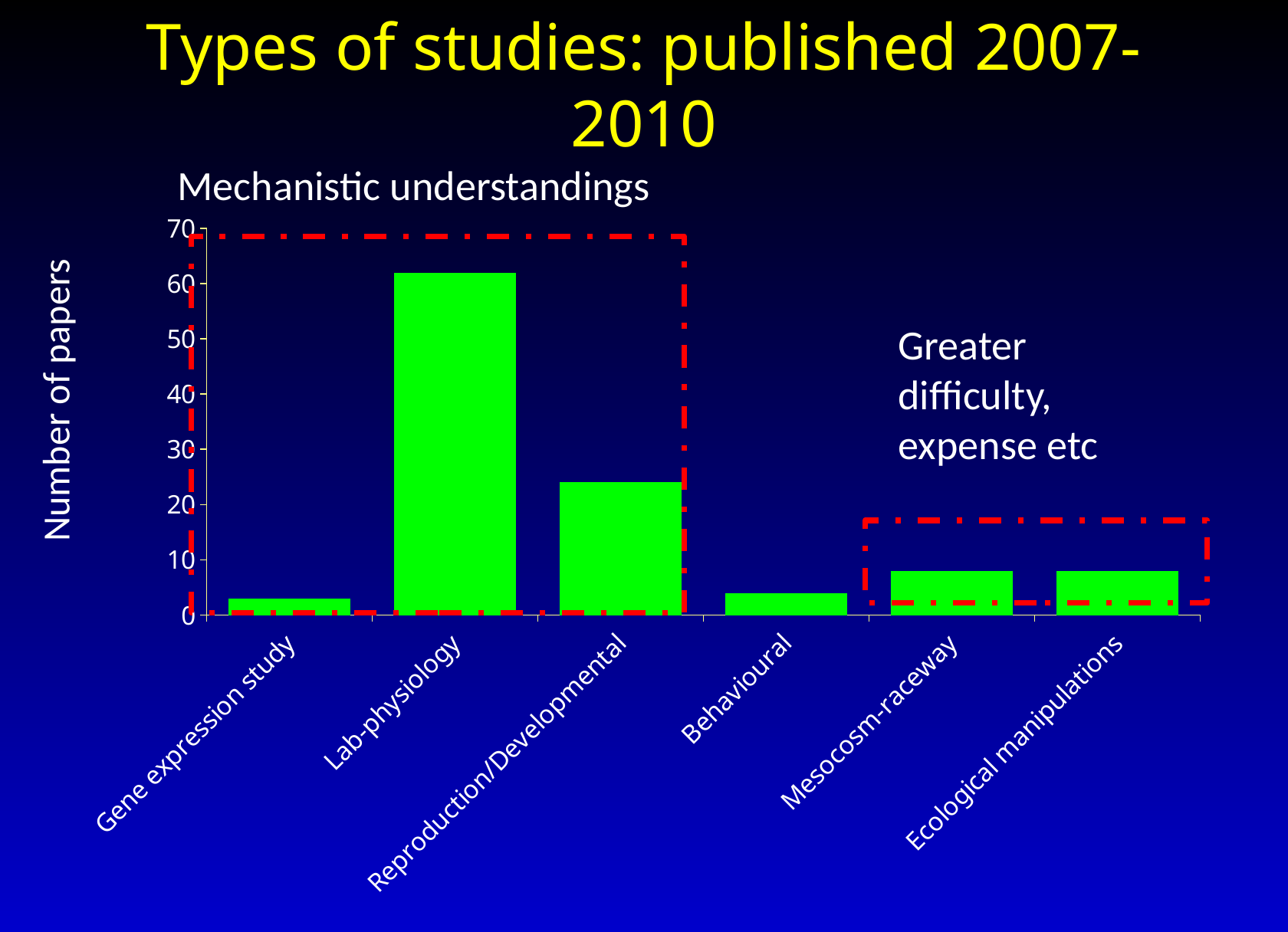
Is the value for Reproduction/Developmental greater or less than 30? less Is the value for Gene expression study greater or less than 10? less Is the value for Lab-physiology greater or less than 60? greater What colour are the bars in the chart? green What is the label on the y axis of the chart? Number of papers Which has more papers, Lab-physiology or Reproduction/Developmental? Lab-physiology How many categories are shown on the x axis of the chart? 6 Which category has the highest number of papers? Lab-physiology What type of chart is shown on the slide? bar chart Which has more papers, Behavioural or Reproduction/Developmental? Reproduction/Developmental